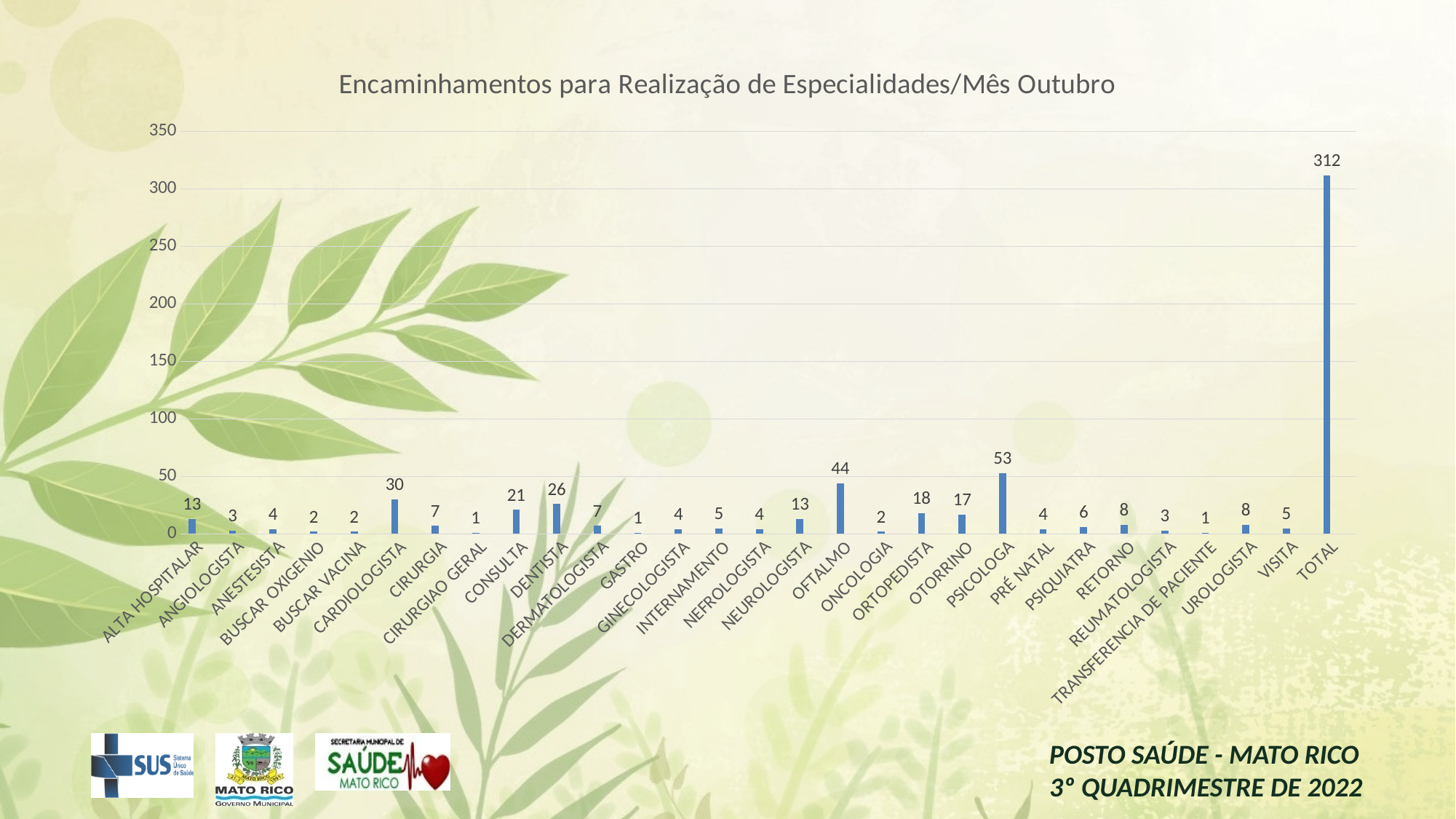
What is the value for DENTISTA? 26 What kind of chart is shown on the slide? Bar chart How many categories are shown on the x axis, including TOTAL? 29 What is the difference between the values for PSICOLOGA and OFTALMO? 9 What is the value for OFTALMO? 44 What is the difference between the values for OFTALMO and CARDIOLOGISTA? 14 What is the value for CARDIOLOGISTA? 30 Is the value for TOTAL greater or less than 300? greater Excluding the TOTAL bar, which category has the highest value? PSICOLOGA What is the value for PSICOLOGA? 53 What is the value shown for TOTAL? 312 Which is larger, the value for ORTOPEDISTA or the value for OTORRINO? ORTOPEDISTA